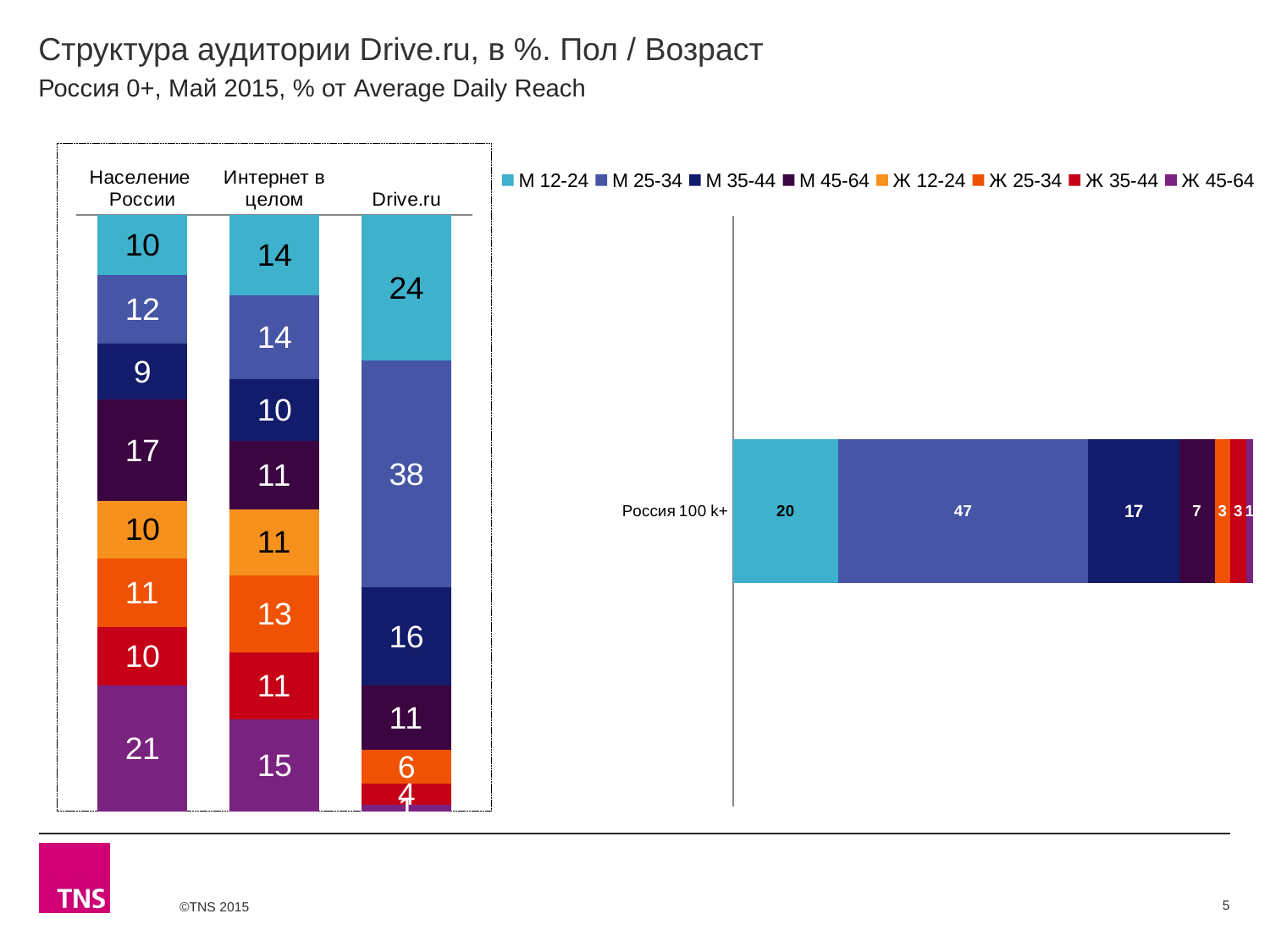
In the left chart, what is the value for М 45-64 in the Население России bar? 17 How many bars are shown in the left chart? 3 In the left chart, which bar has the larger М 12-24 value: Интернет в целом or Население России? Интернет в целом In the left chart, which series has the largest segment in the Население России bar? Ж 45-64 In the right chart (Россия 100 k+), what is the value for М 35-44? 17 In the left chart, what is the value for М 25-34 in the Drive.ru bar? 38 In the right chart (Россия 100 k+), which series has the largest segment? М 25-34 How many series does the legend list? 8 In the left chart, what is the value for Ж 45-64 in the Интернет в целом bar? 15 In the left chart, what is the total of the Население России stacked bar? 100 In the right chart (Россия 100 k+), what is the value for М 25-34? 47 In the left chart, what is the difference between the М 25-34 value for Drive.ru and the М 25-34 value for Население России? 26